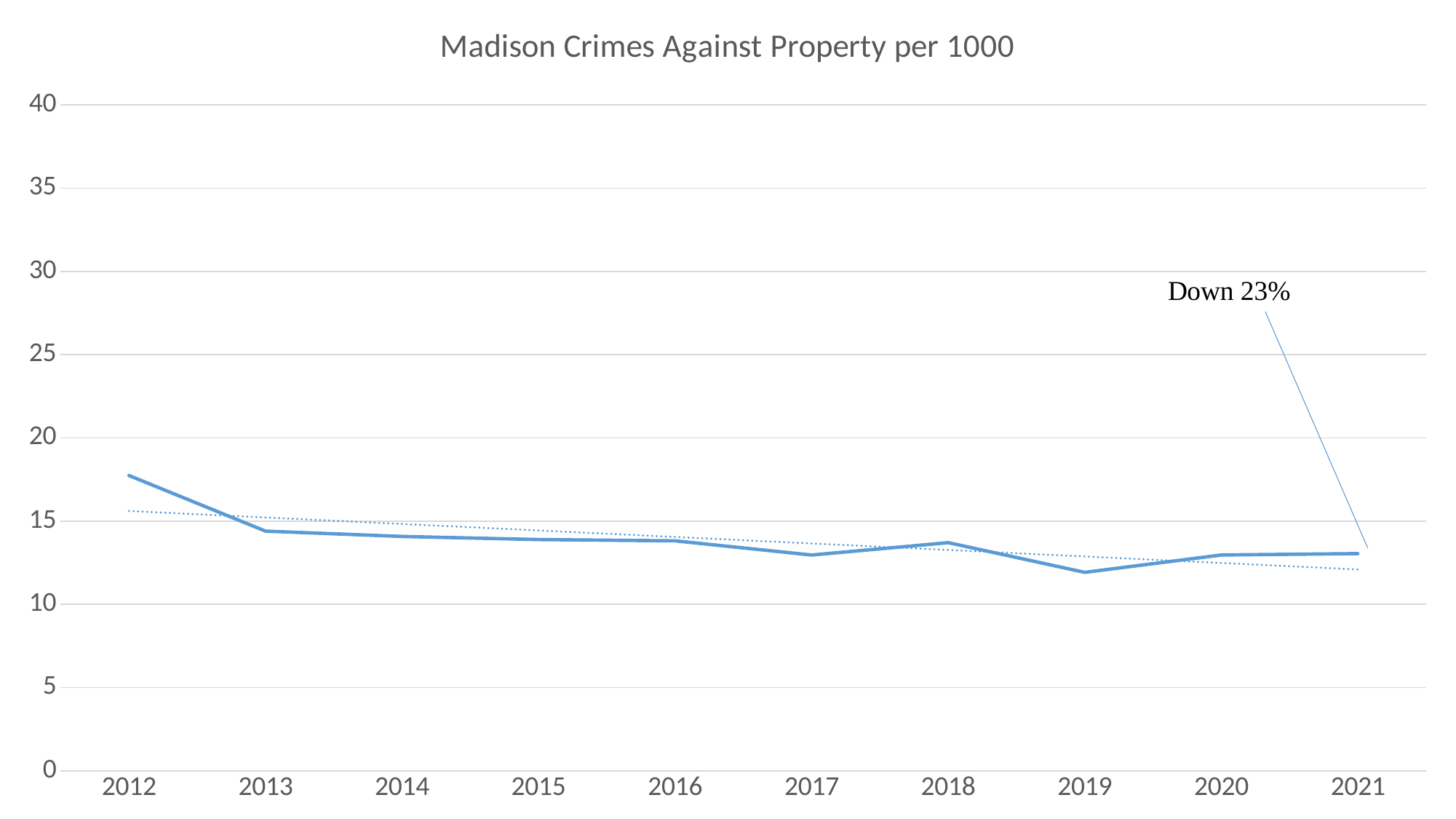
Is the value for 2019 greater or less than 15? less Which year has the highest crimes against property per 1000? 2012 What is the title of the chart? Madison Crimes Against Property per 1000 Which year has the larger value, 2018 or 2019? 2018 What kind of chart is shown on the slide? line chart Is the value for 2021 greater or less than 10? greater Is the value for 2012 greater or less than 15? greater How many years are plotted along the x axis? 10 Do the values generally rise or fall from 2012 to 2021? fall Which year has the larger value, 2012 or 2013? 2012 Which year has the lowest crimes against property per 1000? 2019 What does the annotation pointing to the 2021 data point say? Down 23%